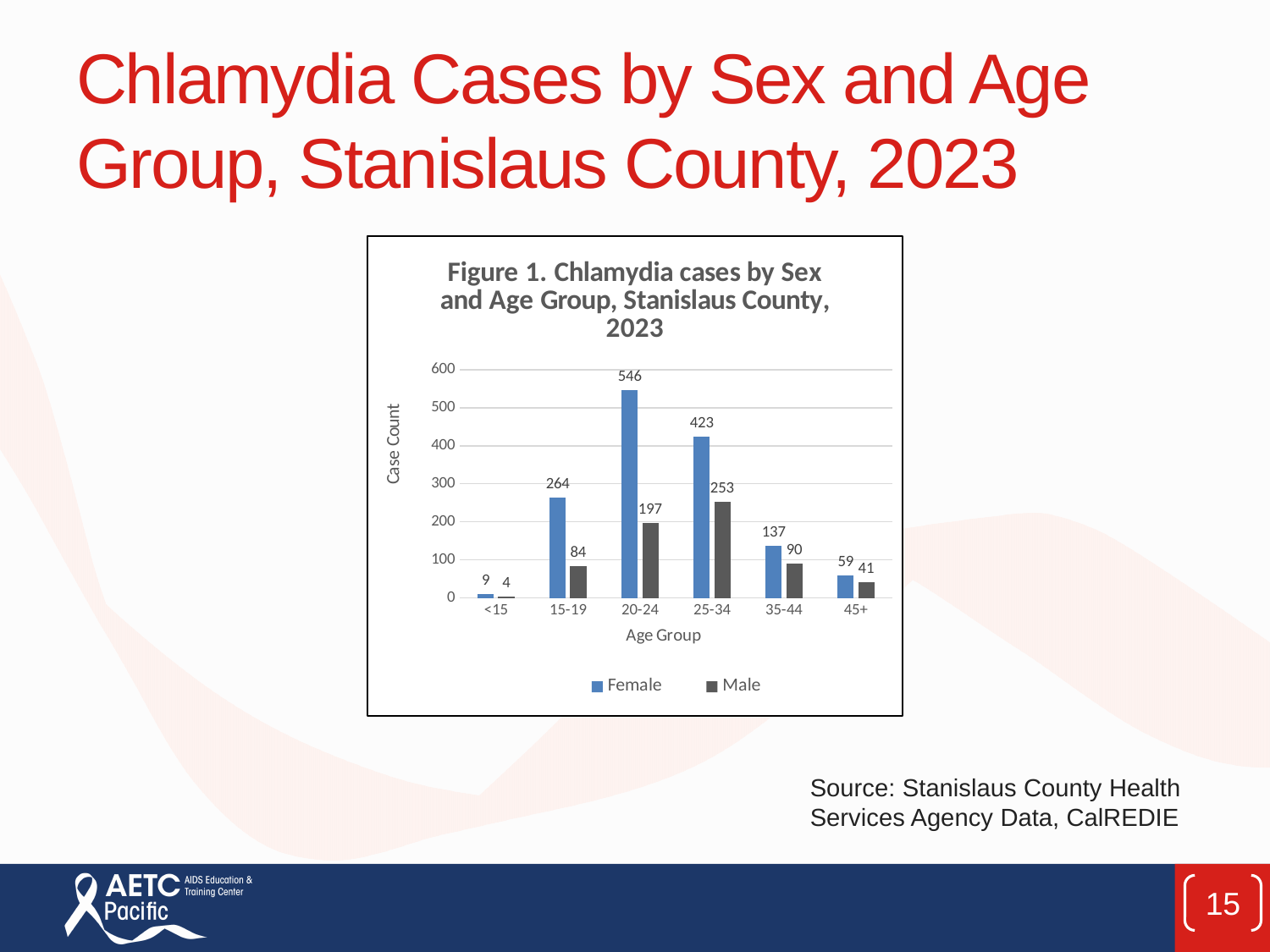
How many age groups are shown on the x axis? 6 Which age group has the highest Male case count? 25-34 Which is larger, the Male case count for 20-24 or the Male case count for 35-44? Male case count for 20-24 What is the Female case count for the 45+ age group? 59 Which age group has the lowest Female case count? <15 What kind of chart is shown on the slide? Bar chart What is the difference between the Female and Male case counts for the 15-19 age group? 180 What is the Female case count for the 20-24 age group? 546 How many series does the legend list? 2 Is the Female case count for the 25-34 age group greater or less than 400? greater What is the label of the y axis? Case Count What is the Male case count for the 25-34 age group? 253